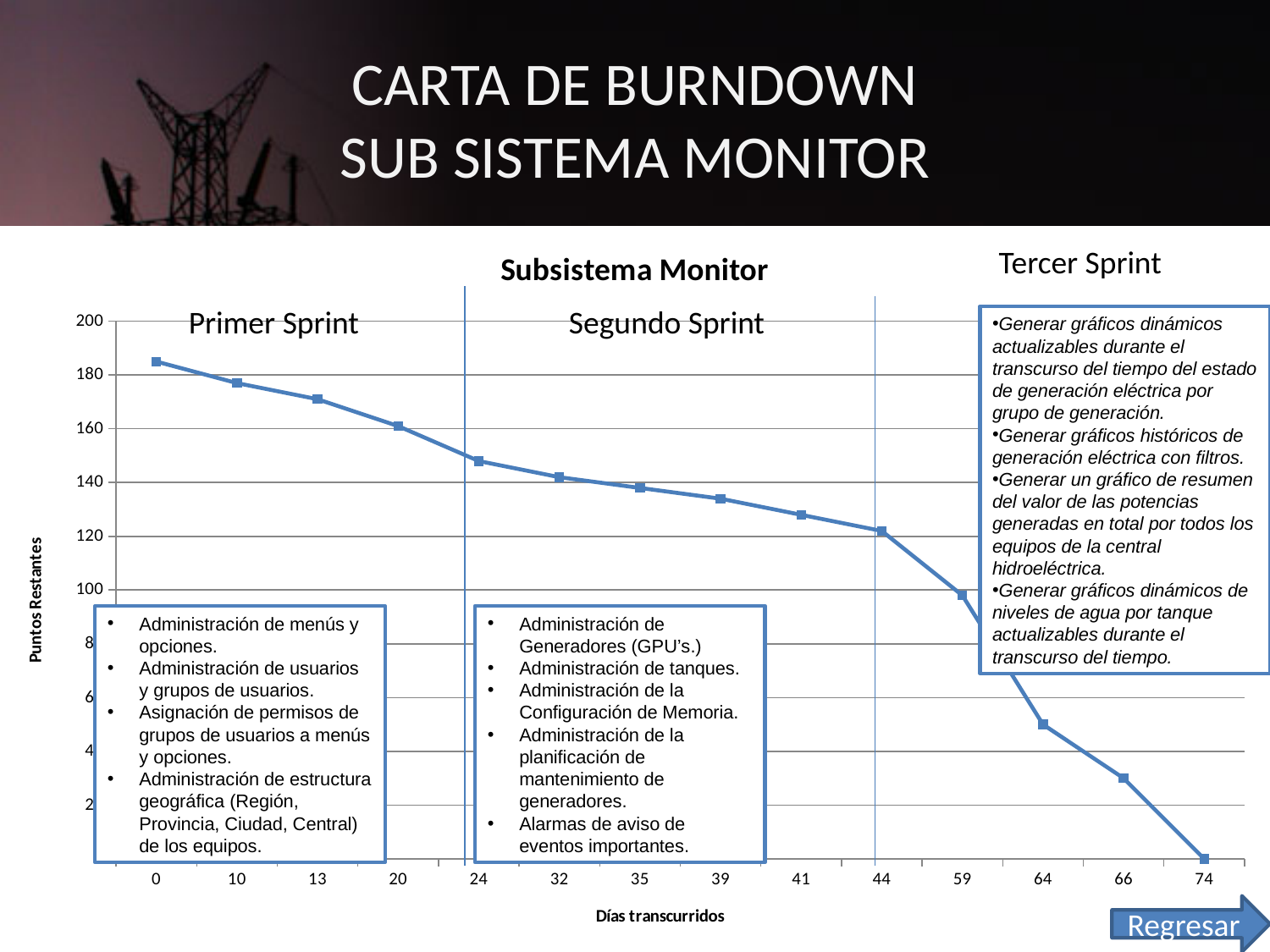
Is the value for day 41 greater or less than 120? greater What is the label of the vertical axis of the chart? Puntos Restantes At which day value is the number of Puntos Restantes highest? 0 Is the value for day 64 greater or less than 60? less Which has a larger value, day 20 or day 44? day 20 Is the value for day 13 greater or less than 160? greater Do the values rise or fall as the days transcurridos increase along the x axis? fall At which day value is the number of Puntos Restantes lowest? 74 What is the title of the chart? Subsistema Monitor How many points are plotted on the line? 14 What kind of chart is shown on the slide? line chart